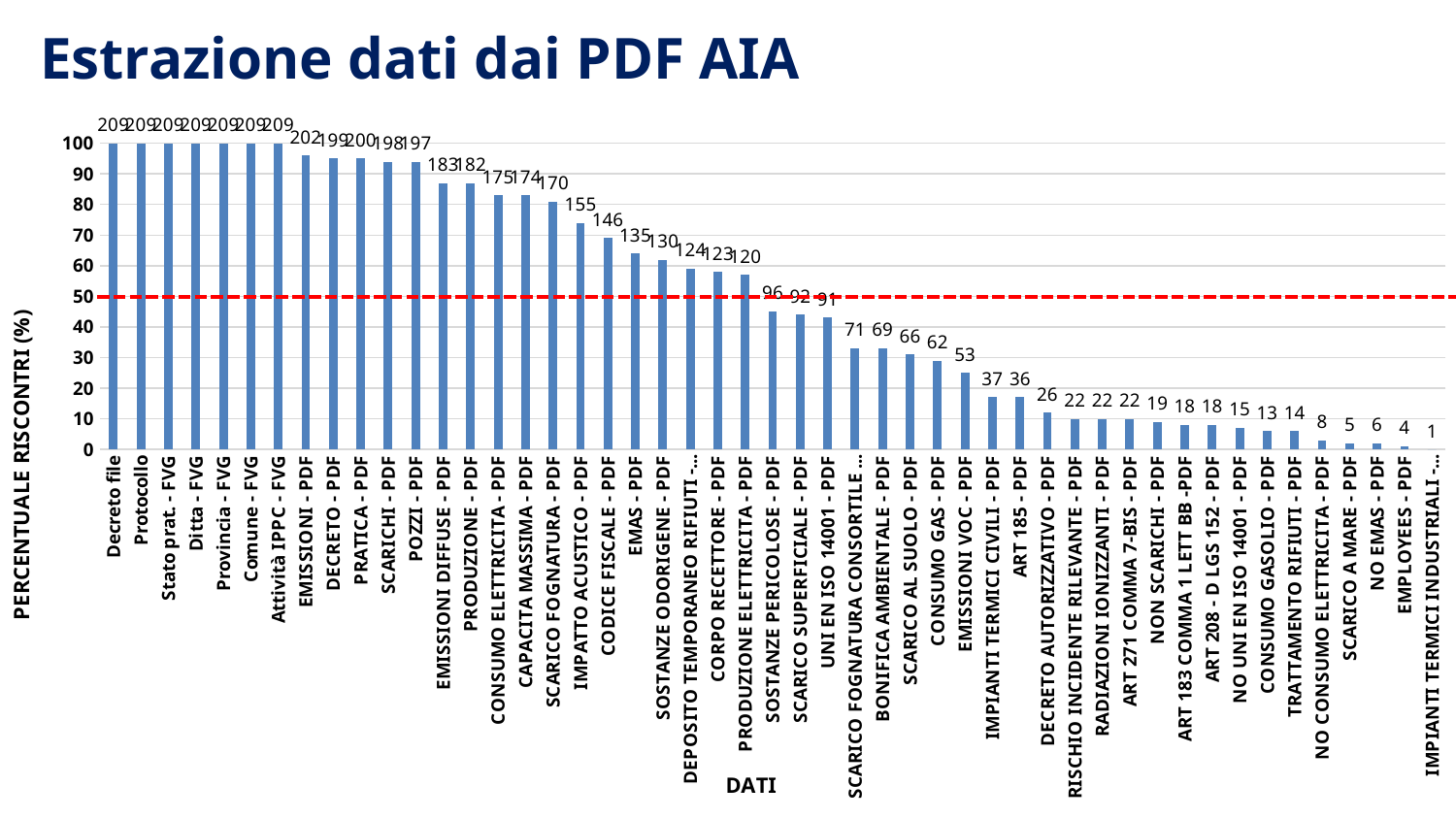
What kind of chart is shown on the slide? bar chart What is the data label shown above the bar for EMPLOYEES - PDF? 4 What is the label of the y axis? PERCENTUALE RISCONTRI (%) Which has a higher bar, SOSTANZE PERICOLOSE - PDF or BONIFICA AMBIENTALE - PDF? SOSTANZE PERICOLOSE - PDF What is the data label shown above the bar for EMISSIONI - PDF? 202 Is the percentage value for CONSUMO GAS - PDF greater or less than 50? less What is the difference between the data labels for IMPATTO ACUSTICO - PDF and EMAS - PDF? 20 Which category has the lowest bar in the chart? IMPIANTI TERMICI INDUSTRIALI What is the data label shown above the bar for EMISSIONI VOC - PDF? 53 Do the bar values rise or fall from left to right along the x axis? fall Is the percentage value for EMAS - PDF greater or less than 50? greater What is the data label shown above the bar for CODICE FISCALE - PDF? 146